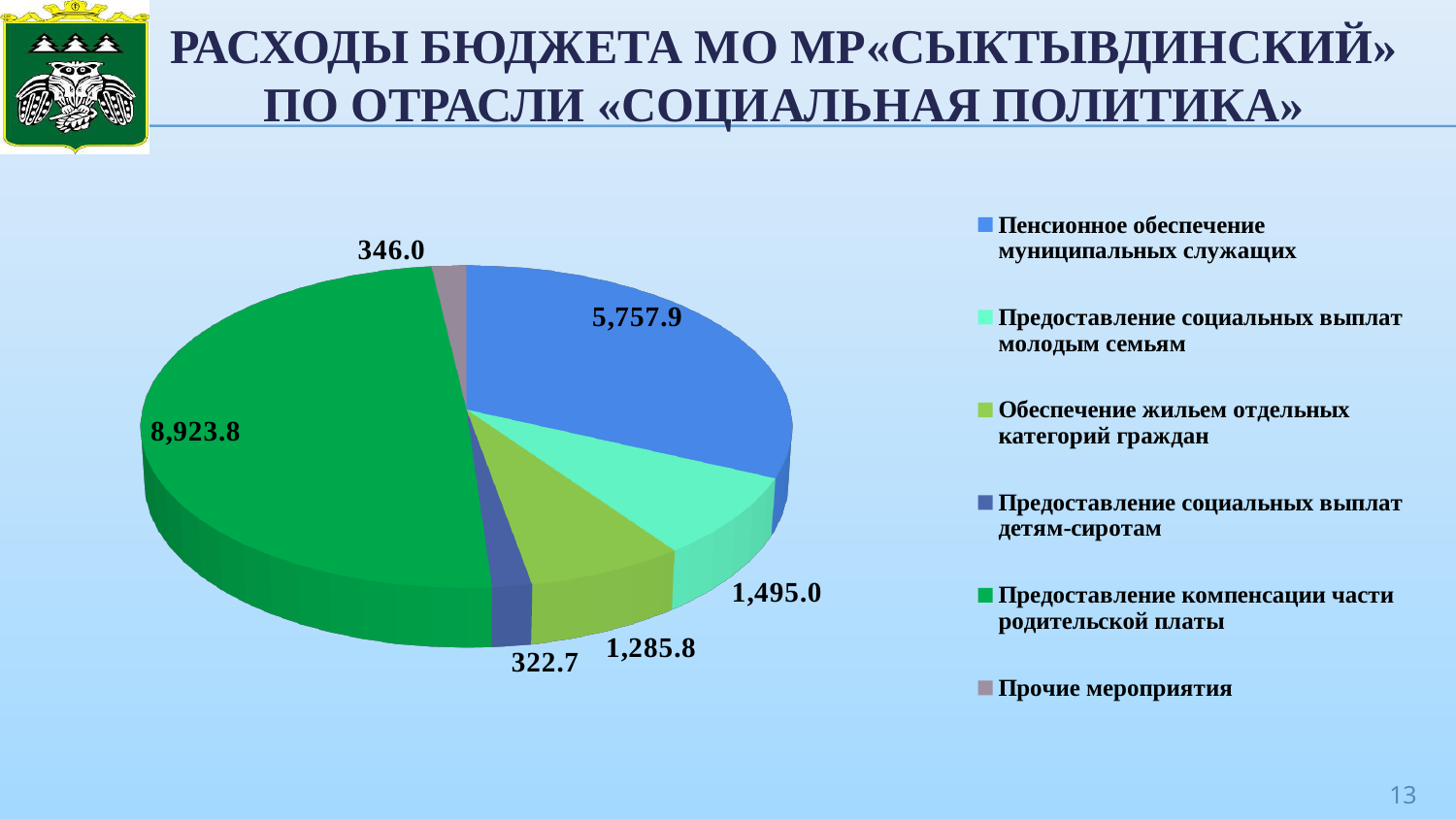
What is the value for Прочие мероприятия? 346.0 What colour is the slice for Прочие мероприятия? Gray Which is larger: the value for Прочие мероприятия or the value for Предоставление социальных выплат детям-сиротам? Прочие мероприятия What is the difference between the values for Предоставление социальных выплат молодым семьям and Обеспечение жильем отдельных категорий граждан? 209.2 What is the difference between the values for Предоставление компенсации части родительской платы and Пенсионное обеспечение муниципальных служащих? 3,165.9 Which category has the largest slice of the pie? Предоставление компенсации части родительской платы What is the value for Предоставление социальных выплат детям-сиротам? 322.7 How many categories does the pie chart show? 6 What is the value for Предоставление компенсации части родительской платы? 8,923.8 Which category has the smallest slice of the pie? Предоставление социальных выплат детям-сиротам What kind of chart is shown on the slide? Pie chart What is the value for Пенсионное обеспечение муниципальных служащих? 5,757.9